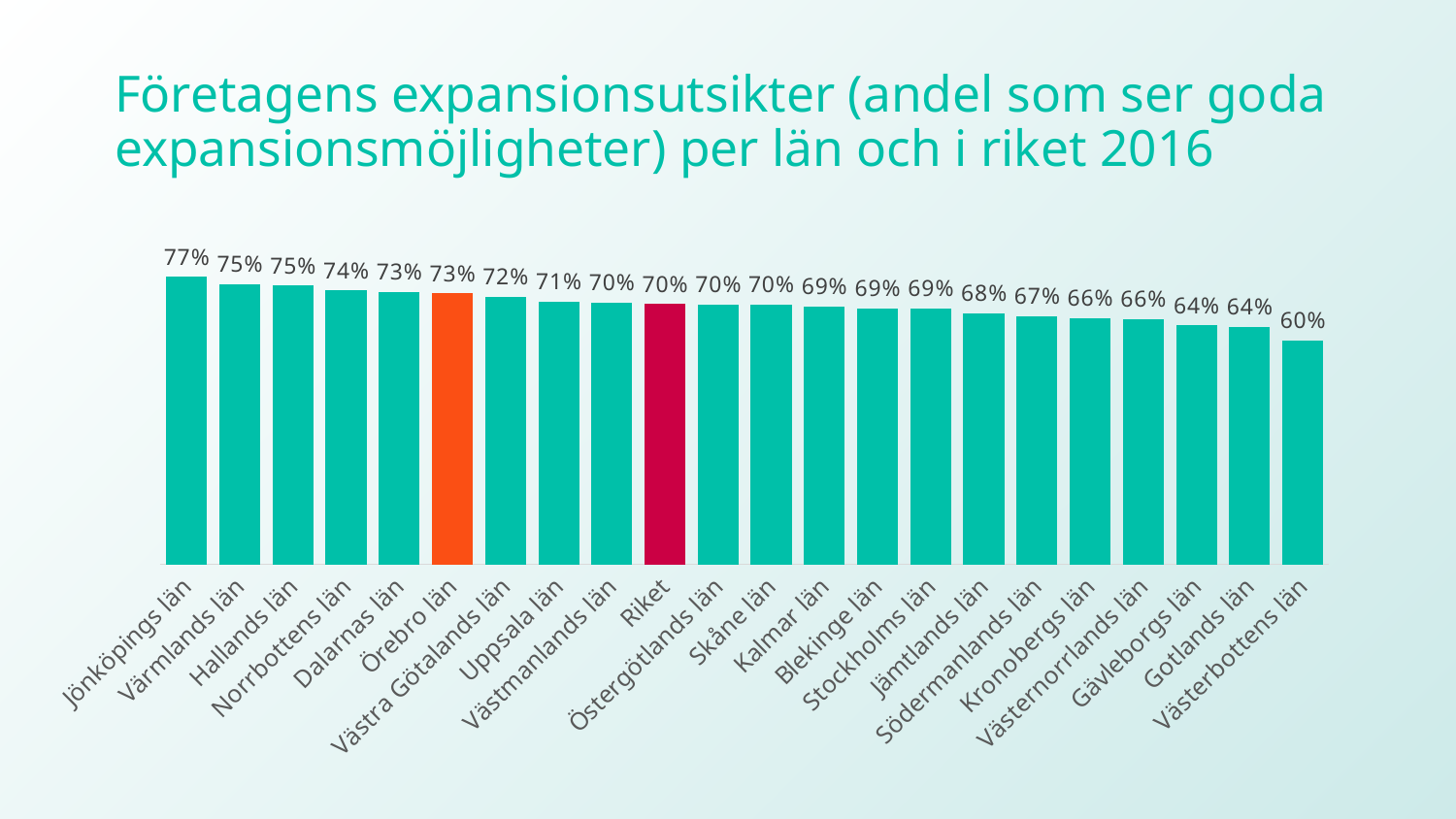
Which is larger, the value for Norrbottens län or the value for Gotlands län? Norrbottens län Which category has the highest value? Jönköpings län What is the difference between the values for Jönköpings län and Västerbottens län? 17% What kind of chart is this? Bar chart Which category has the lowest value? Västerbottens län What is the value for Örebro län? 73% What is the value for Jönköpings län? 77% What is the difference between the values for Örebro län and Riket? 3% What is the value for Stockholms län? 69% What is the value for Riket? 70% How many categories are shown on the x axis? 22 Which bar is coloured orange? Örebro län